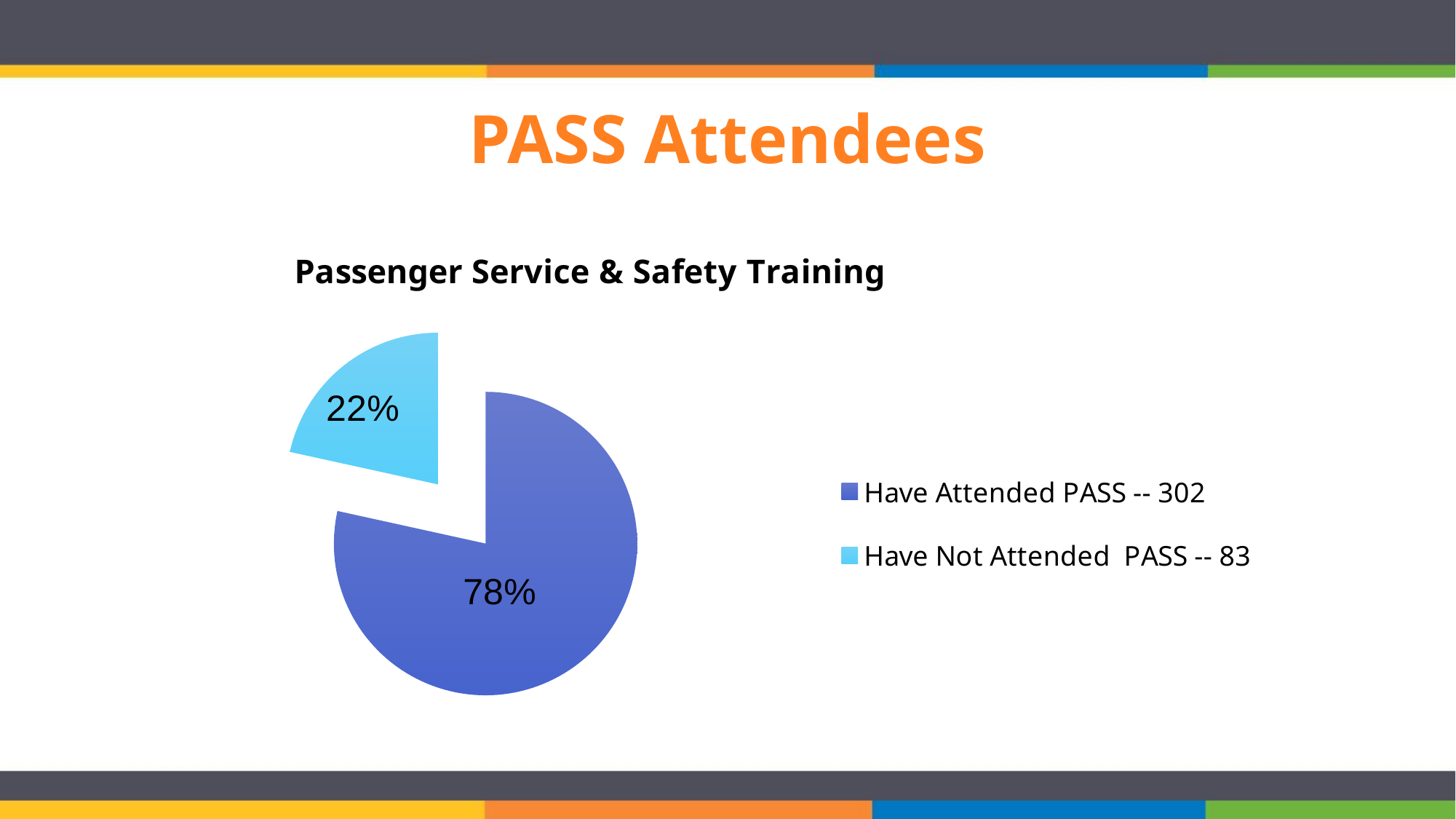
Which colour represents the 'Have Not Attended PASS' slice? Light blue What is the title of the chart? Passenger Service & Safety Training According to the legend, how many people have attended PASS? 302 How many entries does the legend list? 2 What percentage of the pie is labelled for the 'Have Not Attended PASS' slice? 22% According to the legend, how many people have not attended PASS? 83 Which category has the largest slice of the pie? Have Attended PASS Which category has the smallest slice of the pie? Have Not Attended PASS What percentage of the pie is labelled for the 'Have Attended PASS' slice? 78% How many slices does the pie chart have? 2 What is the difference between the number who have attended PASS and the number who have not? 219 What type of chart is shown on the slide? Pie chart